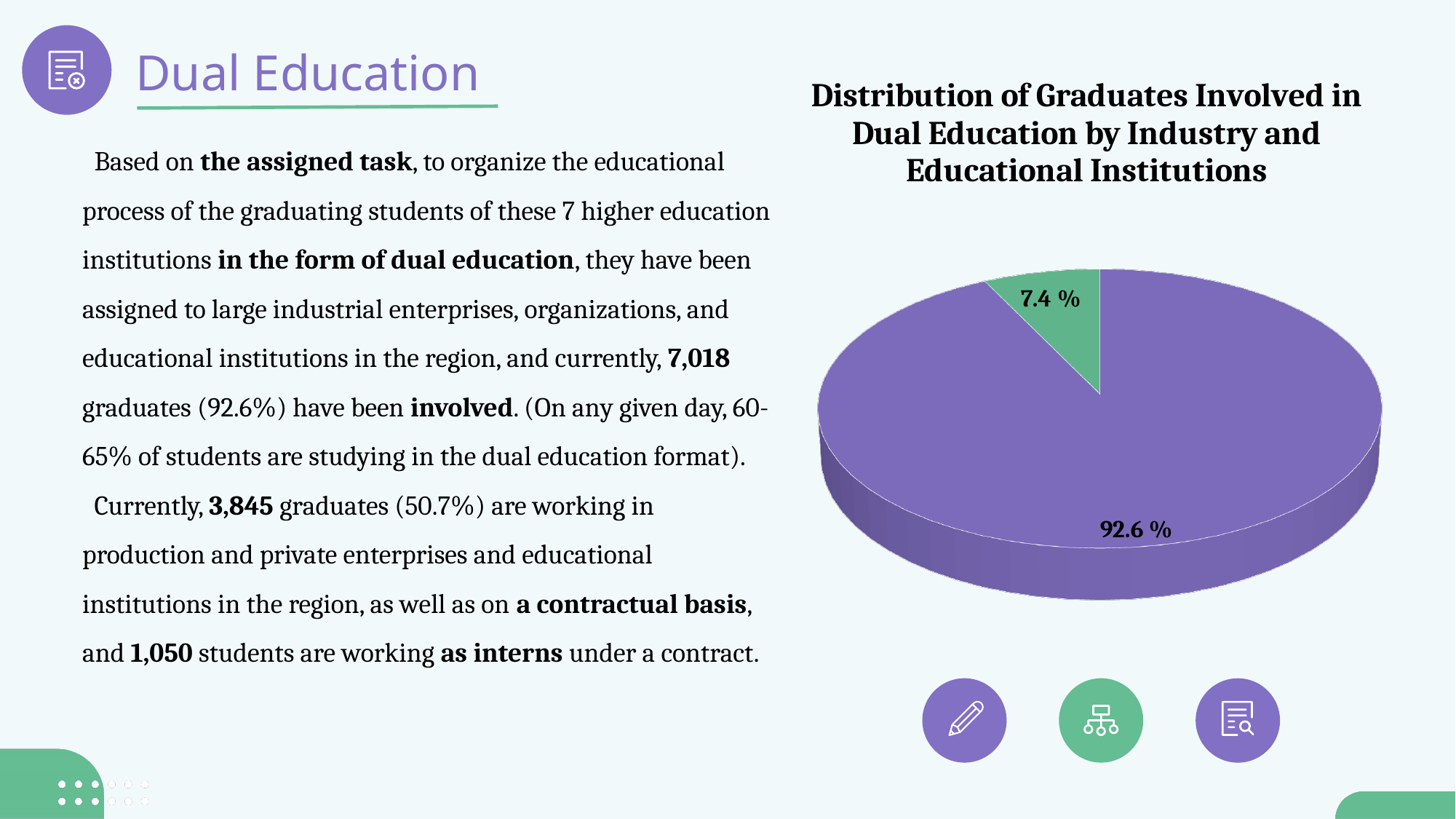
What is the difference in percentage points between the purple slice and the green slice? 85.2 What percentage is shown on the green slice of the pie chart? 7.4 % What share of the pie does the green slice represent? 7.4 % What kind of chart is shown on the slide? pie chart What percentage is shown on the purple slice of the pie chart? 92.6 % What is the title of the pie chart? Distribution of Graduates Involved in Dual Education by Industry and Educational Institutions What is the value of the largest slice of the pie chart? 92.6 % What is the value of the smallest slice of the pie chart? 7.4 % What colour is the largest slice of the pie chart? purple Is the value of the purple slice greater or less than 50%? greater Which slice is larger, the purple one or the green one? the purple one How many slices does the pie chart have? 2